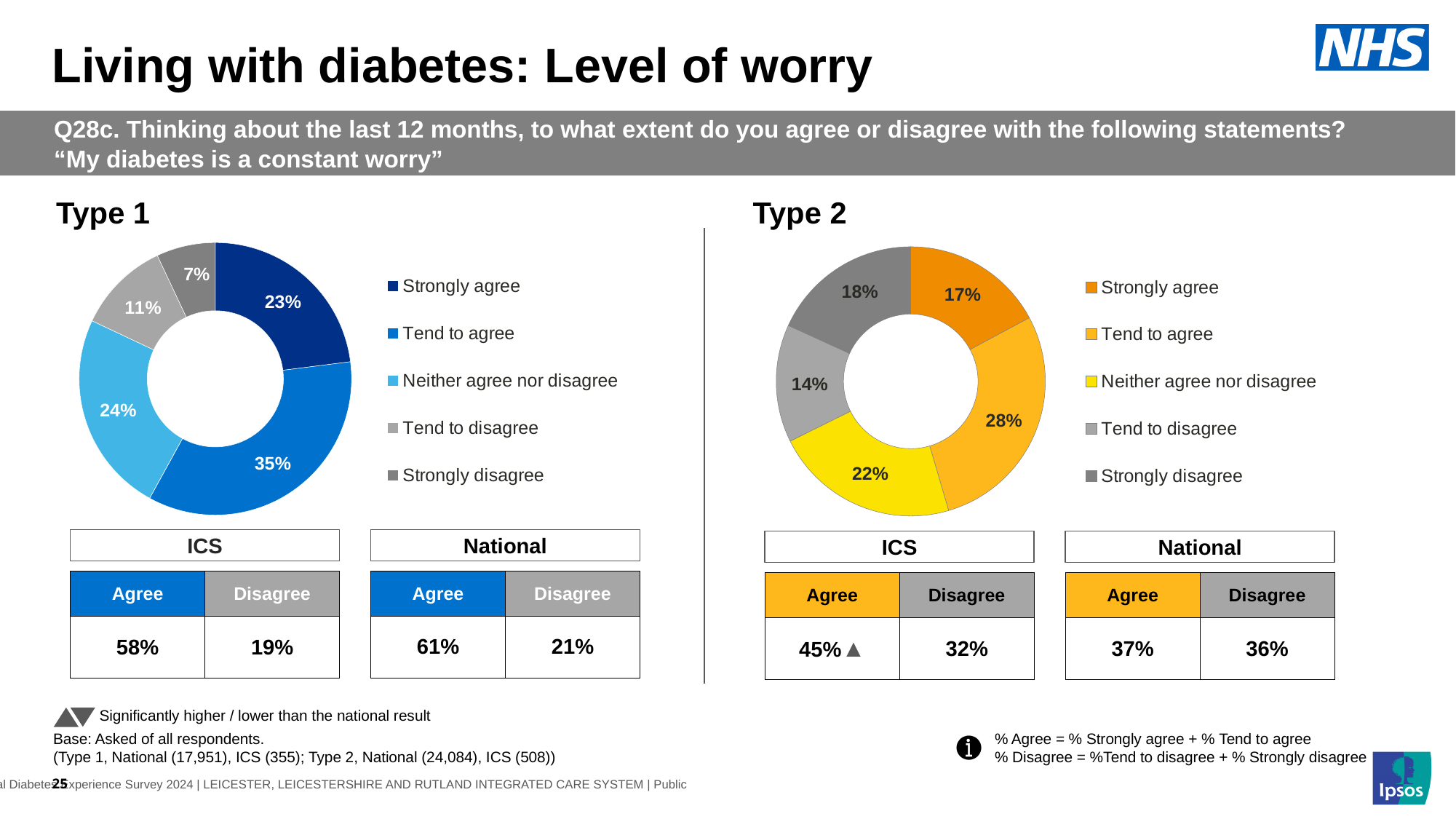
In the Type 2 chart, what percentage of respondents neither agree nor disagree? 22% What kind of chart is used to show the Type 1 results? Donut (pie) chart In the Type 2 chart, which response category has the smallest share? Tend to disagree In the Type 1 chart, what colour represents Neither agree nor disagree? Light blue How many response categories does the Type 2 chart's legend list? 5 In the Type 1 chart, what percentage of respondents strongly disagree? 7% In the Type 1 chart, what is the difference between the Tend to agree and Strongly agree shares? 12 percentage points In the Type 2 chart, what percentage of respondents strongly agree? 17% In the Type 1 chart, which response category has the largest share? Tend to agree In the Type 2 chart, what is the combined share of Tend to disagree and Strongly disagree? 32% In the Type 1 chart, what percentage of respondents said they tend to agree? 35% In the Type 2 chart, which is larger: the Strongly disagree share or the Strongly agree share? Strongly disagree